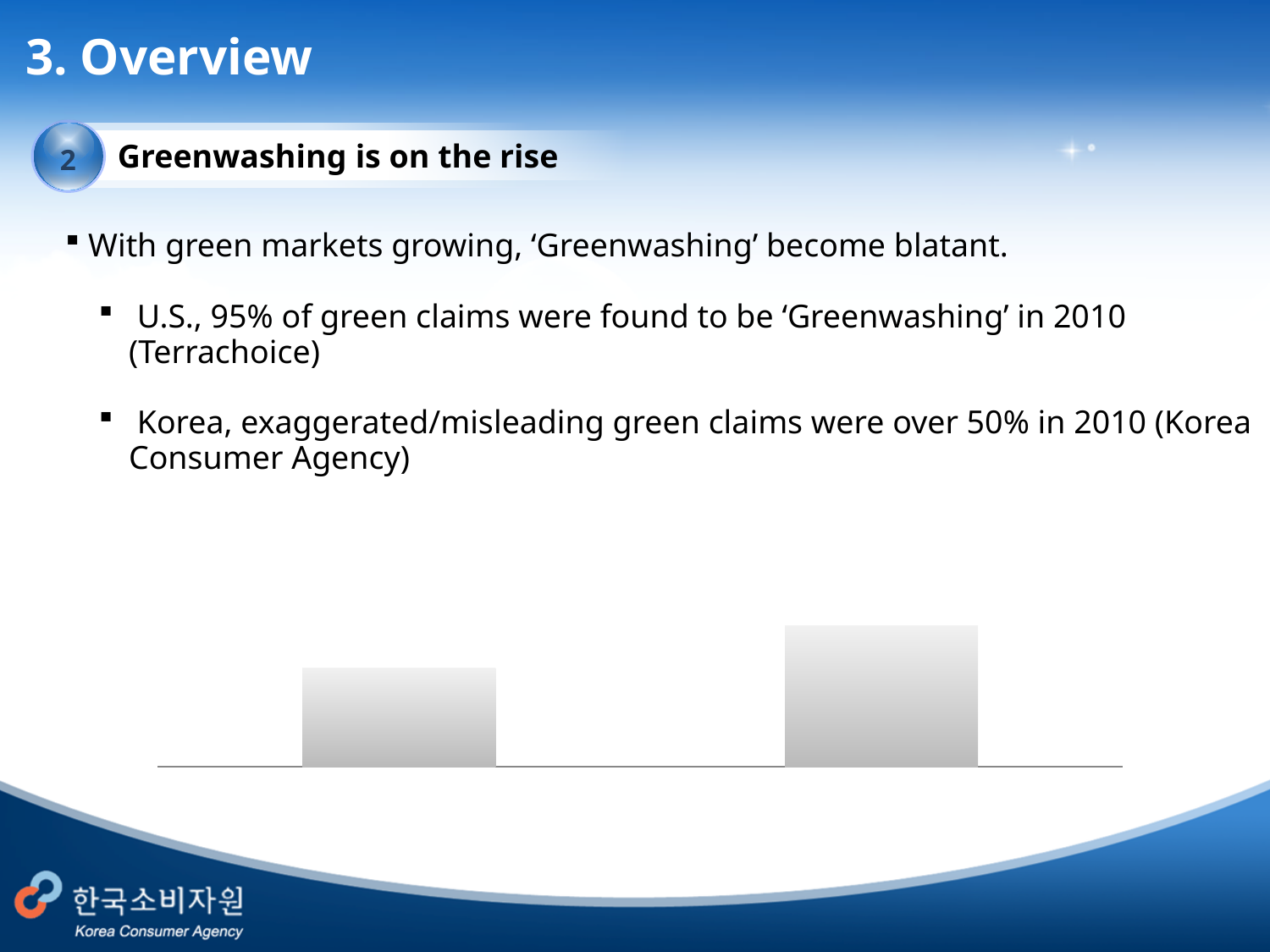
In the chart at the bottom of the slide, which bar is taller, the left one or the right one? the right one What kind of chart is shown at the bottom of the slide? bar chart Does the chart at the bottom of the slide display any data labels on its bars? No How many bars does the chart at the bottom of the slide show? 2 Does the chart at the bottom of the slide have a legend? No In the chart at the bottom of the slide, do the bar heights rise or fall from left to right? rise